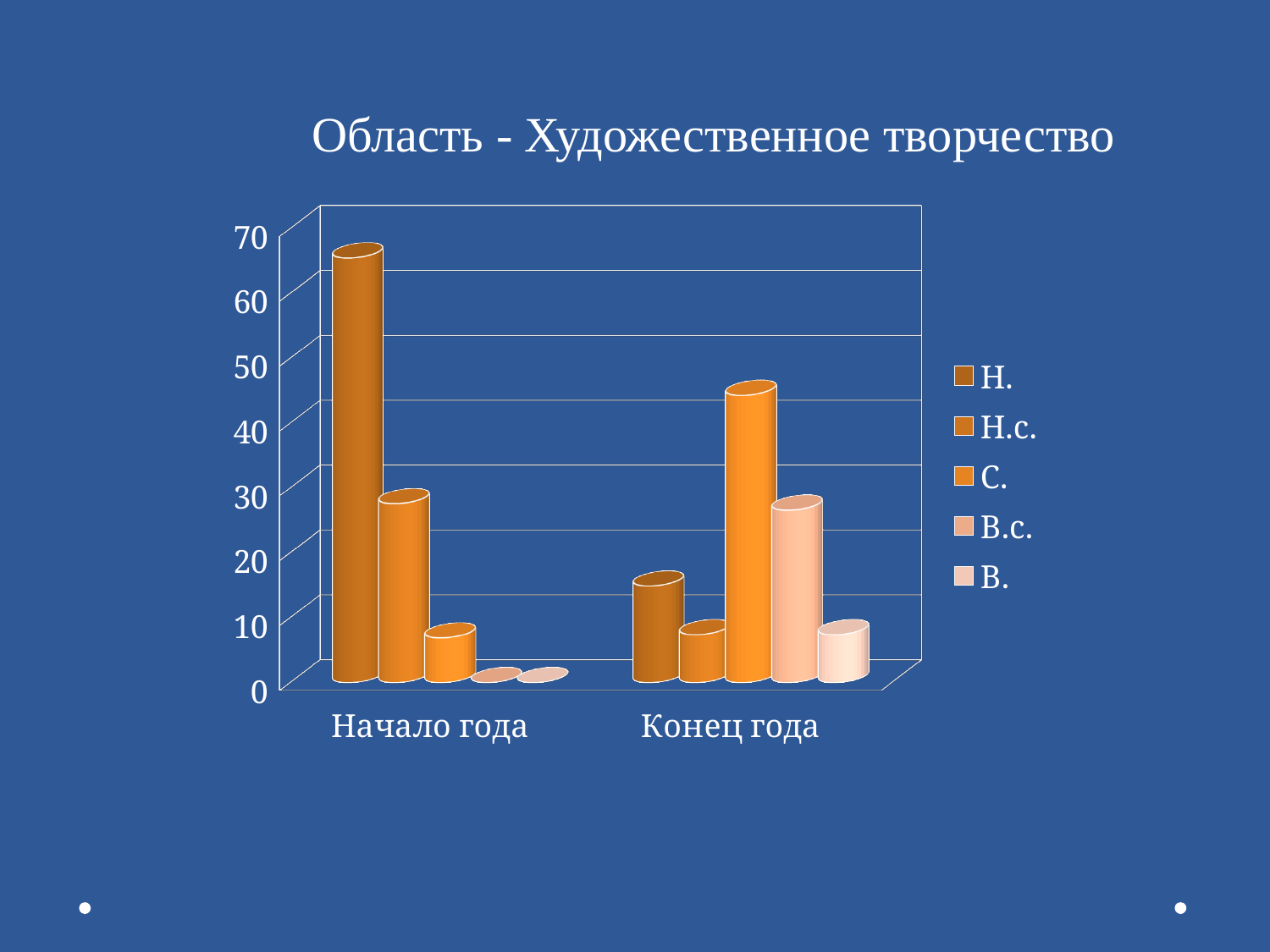
Does the value for С. rise or fall from Начало года to Конец года? rise What is the title of the chart? Область - Художественное творчество Which series has the highest value for Начало года? Н. Is the value for Н. at Конец года greater or less than 20? less Is the value for Н. at Начало года greater or less than 50? greater Is the value for Н. larger at Начало года or at Конец года? Начало года Is the value for В.с. at Конец года greater or less than 20? greater Which series has the highest value for Конец года? С. What kind of chart is shown on the slide? bar chart How many series does the legend list? 5 How many categories are shown on the x axis? 2